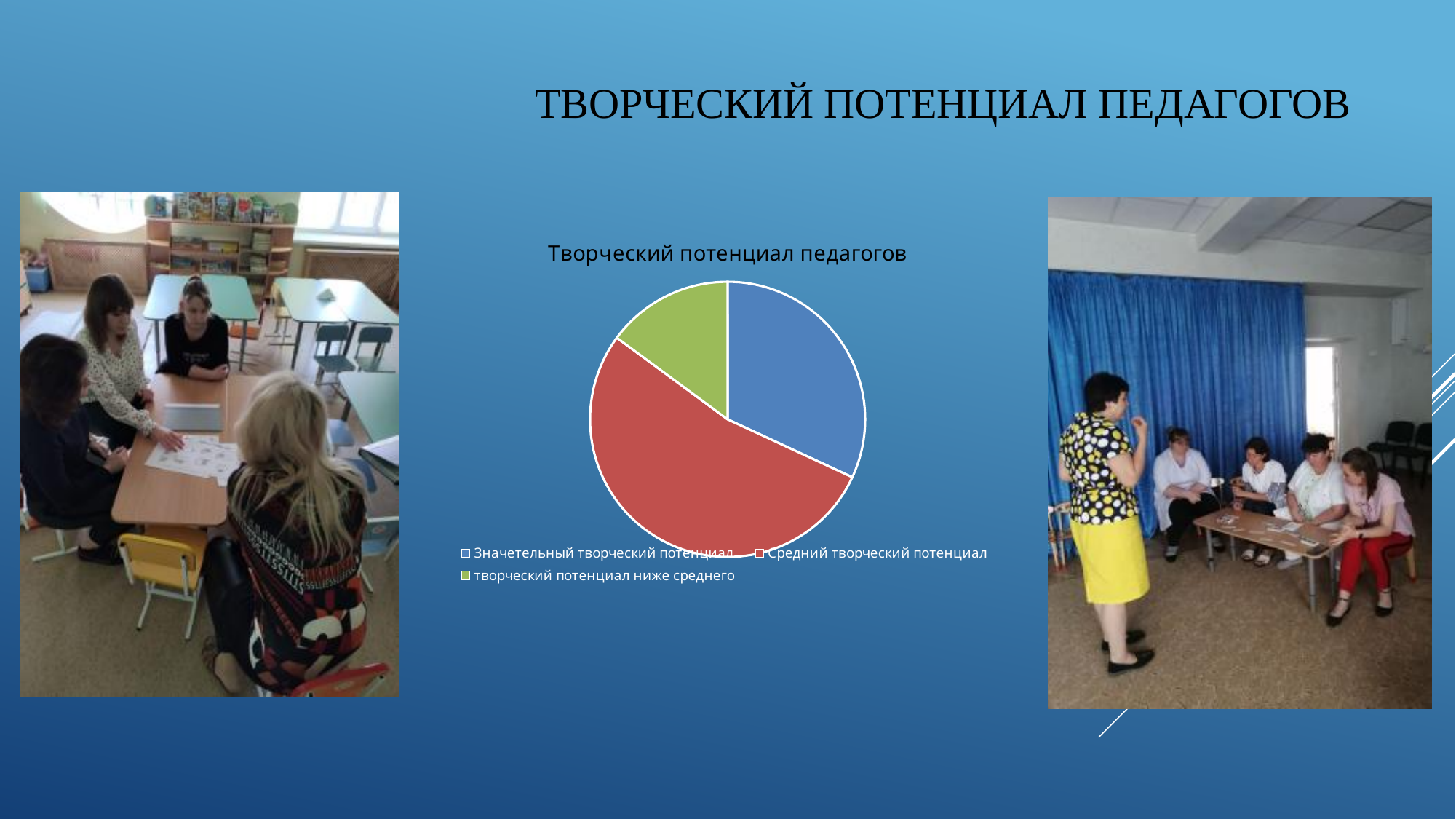
What colour is the slice for Средний творческий потенциал? Red Which slice is larger: Средний творческий потенциал or Значетельный творческий потенциал? Средний творческий потенциал Which slice is larger: Значетельный творческий потенциал or творческий потенциал ниже среднего? Значетельный творческий потенциал Which category has the largest slice of the pie? Средний творческий потенциал Which category has the smallest slice of the pie? творческий потенциал ниже среднего How many slices does the pie chart have? 3 What kind of chart is shown on the slide? Pie chart How many entries does the chart legend list? 3 Does the slice for Средний творческий потенциал take up more or less than half of the pie? More What is the title of the chart? Творческий потенциал педагогов